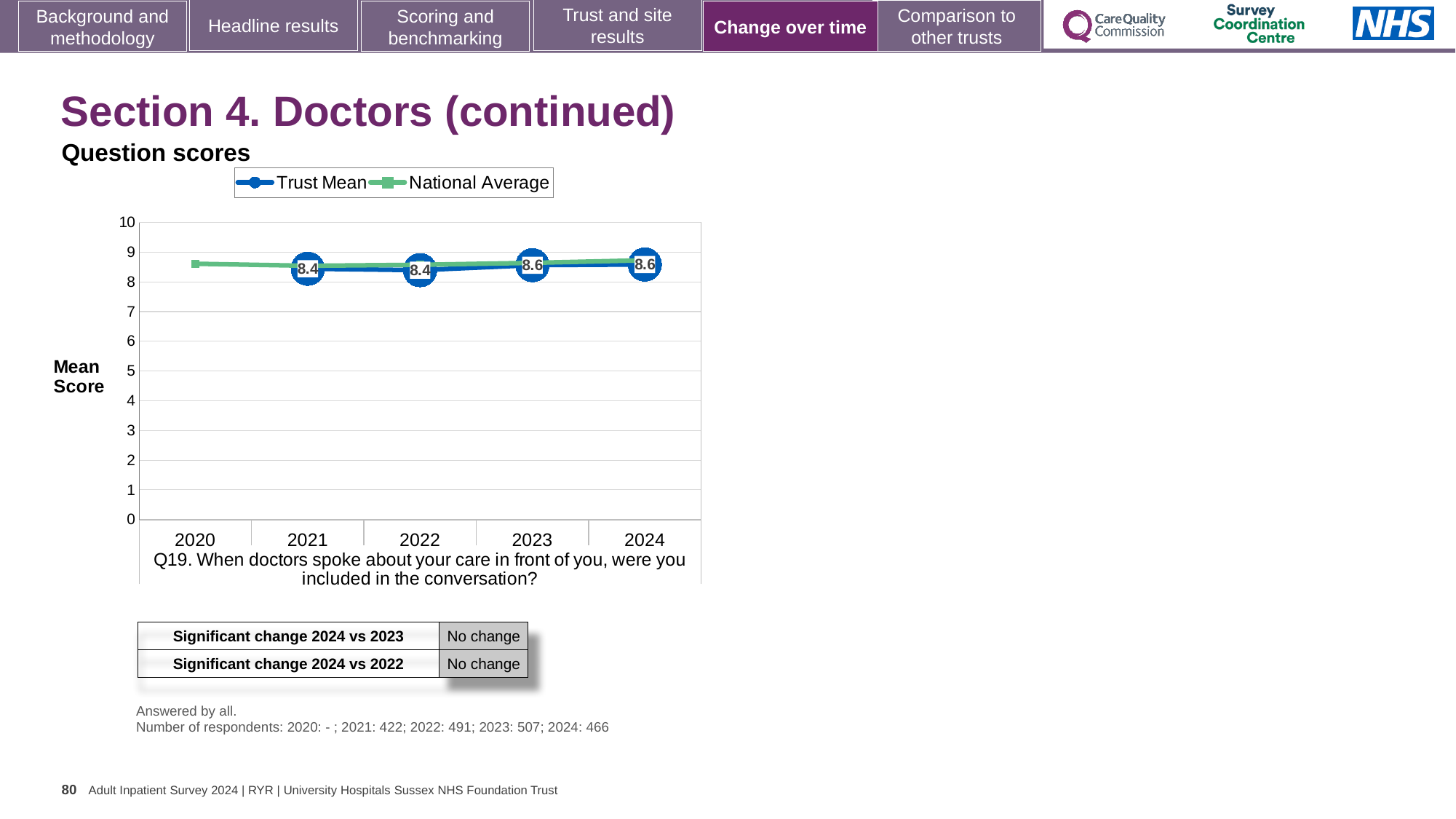
How many years are shown on the x axis of the chart? 5 What is the Trust Mean value for 2023? 8.6 Which is larger, the Trust Mean for 2023 or the Trust Mean for 2022? 2023 Is the National Average value for 2020 greater or less than 8? greater What is the Trust Mean value for 2021? 8.4 What is the Trust Mean value for 2022? 8.4 What is the difference between the Trust Mean in 2024 and the Trust Mean in 2021? 0.2 How many series does the chart legend list? 2 What is the Trust Mean value for 2024? 8.6 Is the National Average value for 2020 greater or less than 9? less What kind of chart is shown on the slide? Line chart Does the Trust Mean rise or fall from 2021 to 2024? Rise